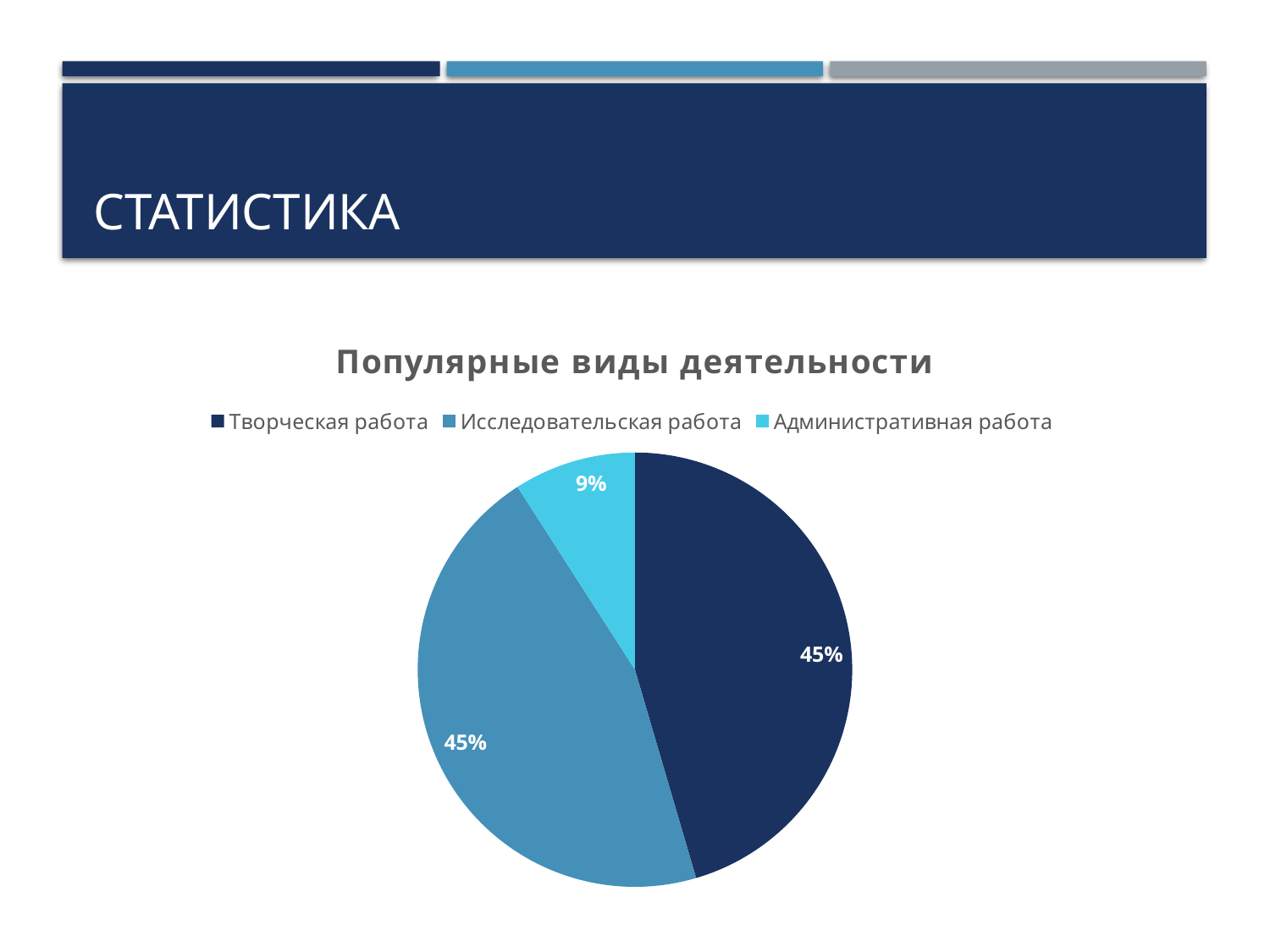
What is the title of the chart? Популярные виды деятельности What share of the pie does Исследовательская работа represent? 45% How many categories are shown in the pie chart? 3 Is the share for Административная работа greater or less than 10%? less What is the difference in percentage points between the Исследовательская работа slice and the Административная работа slice? 36% Which category is shown in the lightest blue colour in the legend? Административная работа What share of the pie does Творческая работа represent? 45% What kind of chart is shown on the slide? pie chart Which category has the smallest slice of the pie? Административная работа Which is larger: the slice for Творческая работа or the slice for Административная работа? Творческая работа What share of the pie does Административная работа represent? 9% Which is larger: the slice for Административная работа or the slice for Исследовательская работа? Исследовательская работа